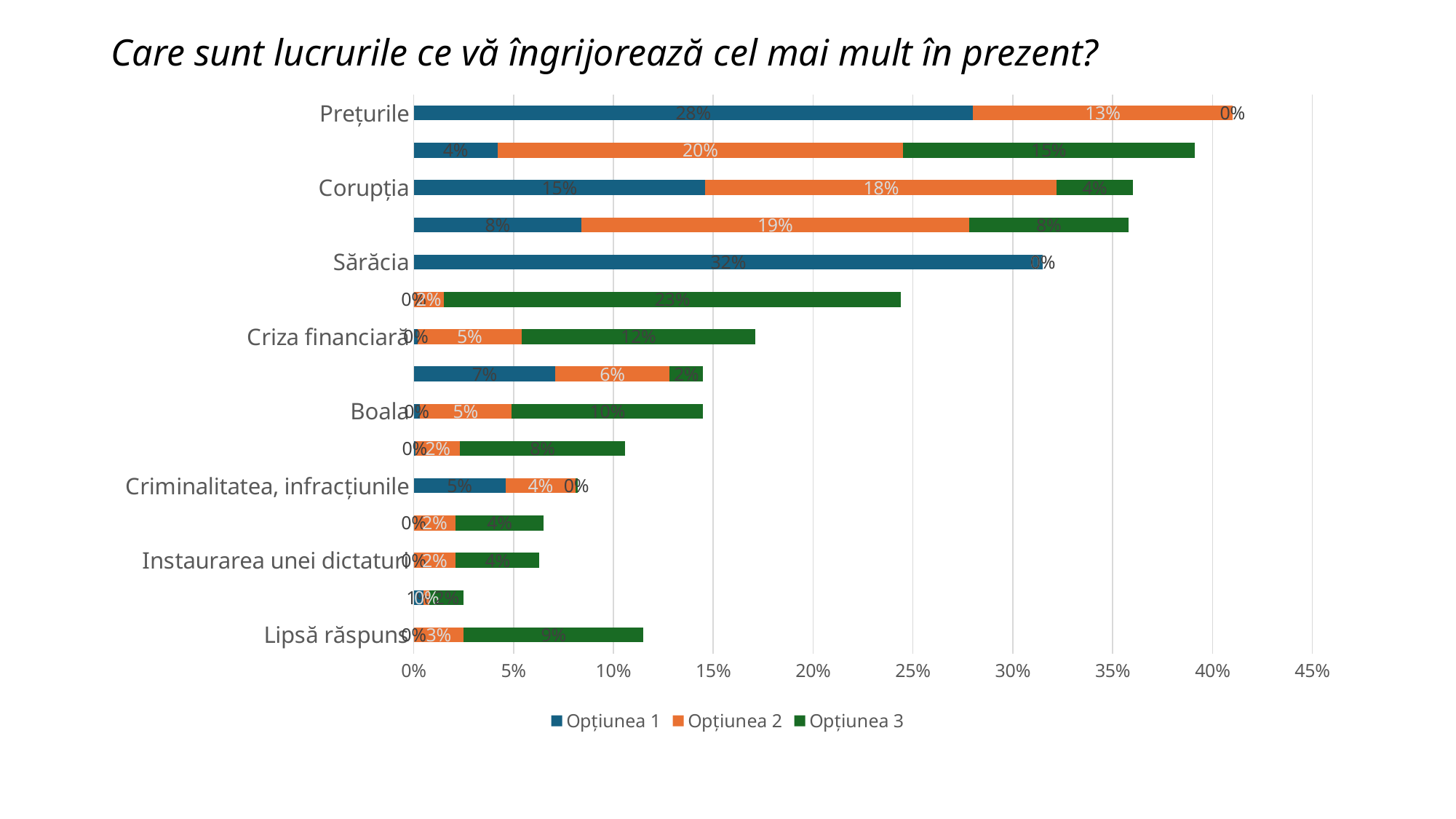
What is the difference between Opțiunea 1 and Opțiunea 2 for Prețurile? 15% How many series does the legend list? 3 What is the value of Opțiunea 1 for Prețurile? 28% What is the value of Opțiunea 3 for Criza financiară? 12% What is the value of Opțiunea 2 for Corupția? 18% What is the title of the chart? Care sunt lucrurile ce vă îngrijorează cel mai mult în prezent? What is the value of Opțiunea 1 for Sărăcia? 32% What is the value of Opțiunea 2 for Instaurarea unei dictaturi? 2% Which is larger for Opțiunea 1: Prețurile or Corupția? Prețurile What is the total of the stacked bar for Prețurile? 41% What is the value of Opțiunea 3 for Lipsă răspuns? 9% What kind of chart is shown on the slide? Stacked bar chart